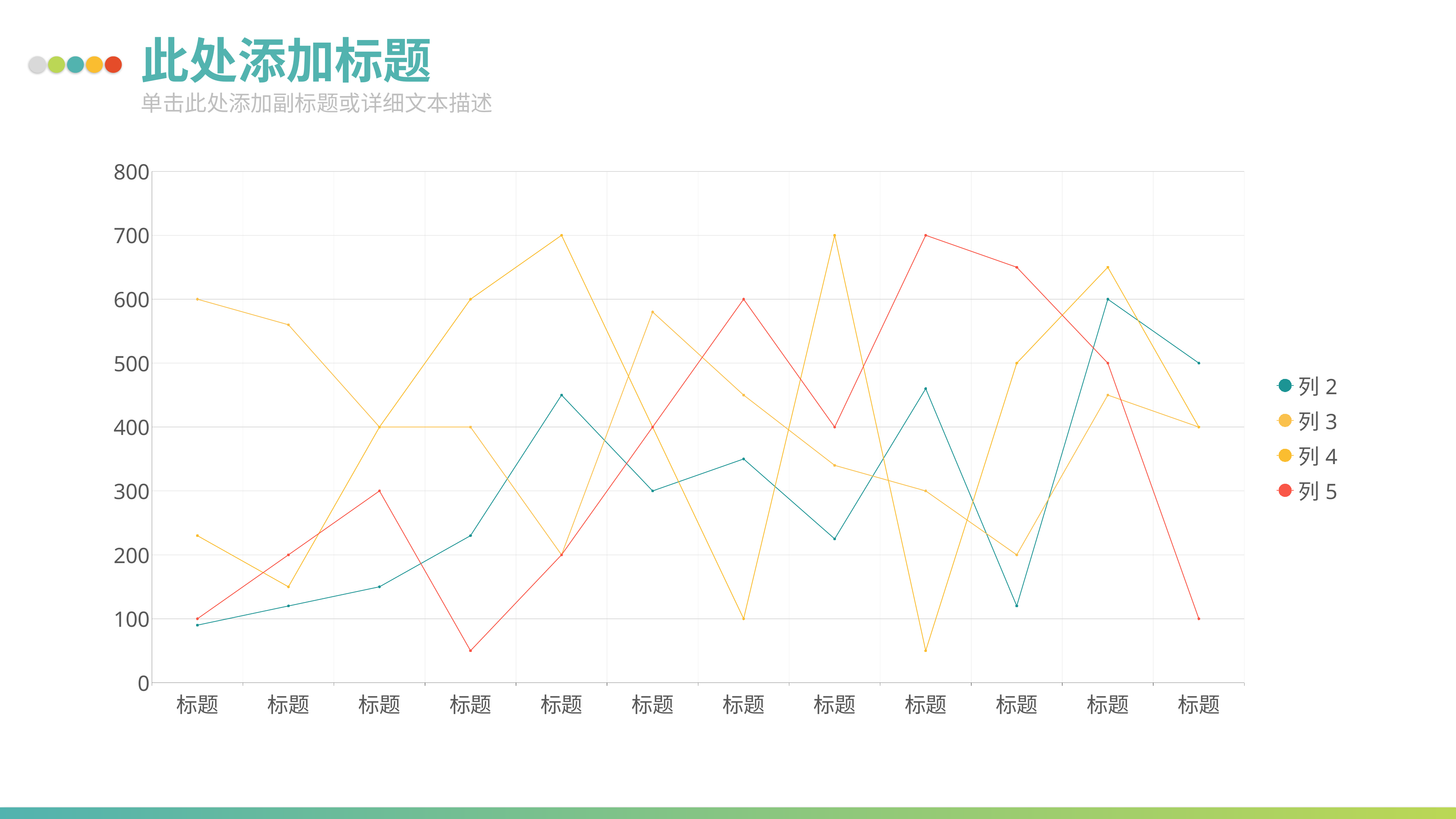
Is the value for 列 5 at the last (rightmost) category greater or less than 300? less Is the value for 列 2 at the last (rightmost) category greater or less than 400? greater How many series does the legend list? 4 How many categories are plotted along the x axis? 12 What are the entries listed in the legend? 列 2, 列 3, 列 4, 列 5 What kind of chart is shown on the slide? line chart Which series has the highest value at the last (rightmost) category? 列 2 Does the 列 2 line rise or fall from the first category to the fourth category? rise Is the value for 列 5 at the first (leftmost) category greater or less than 200? less Which series has the lowest value at the last (rightmost) category? 列 5